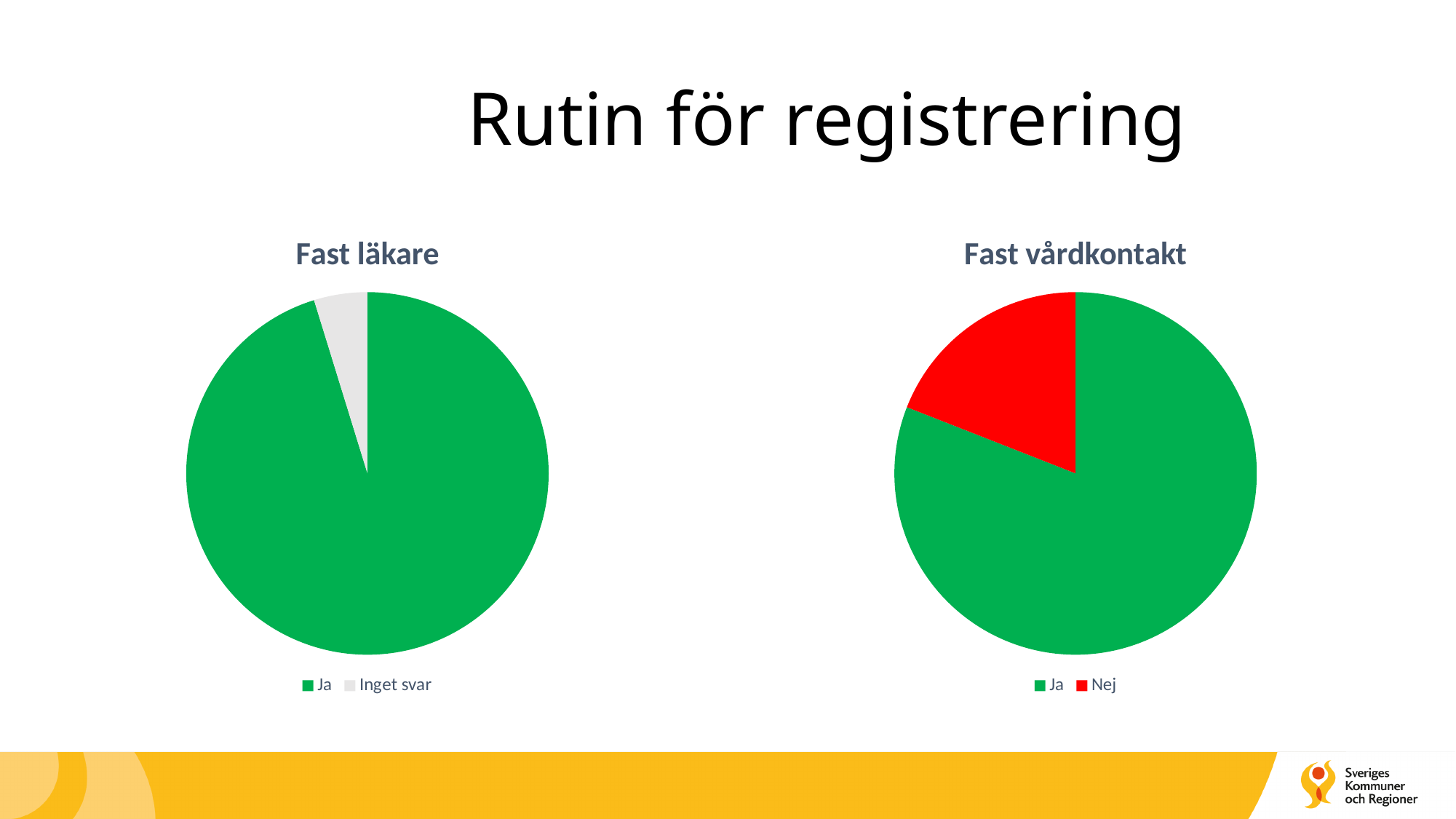
In the "Fast läkare" chart, which category has the smallest slice? Inget svar What are the legend entries of the "Fast vårdkontakt" chart? Ja, Nej What kind of chart is the "Fast läkare" chart? pie chart In the "Fast vårdkontakt" chart, which category has the largest slice? Ja In the "Fast vårdkontakt" chart, which slice is larger, Ja or Nej? Ja In the "Fast läkare" chart, which slice is larger, Inget svar or Ja? Ja In the "Fast läkare" chart, which category has the largest slice? Ja What kind of chart is the "Fast vårdkontakt" chart? pie chart In the "Fast vårdkontakt" chart, how many slices does the pie have? 2 In the "Fast läkare" chart, how many slices does the pie have? 2 In the "Fast vårdkontakt" chart, which category has the smallest slice? Nej In the "Fast läkare" chart, what colour is the Inget svar slice? grey